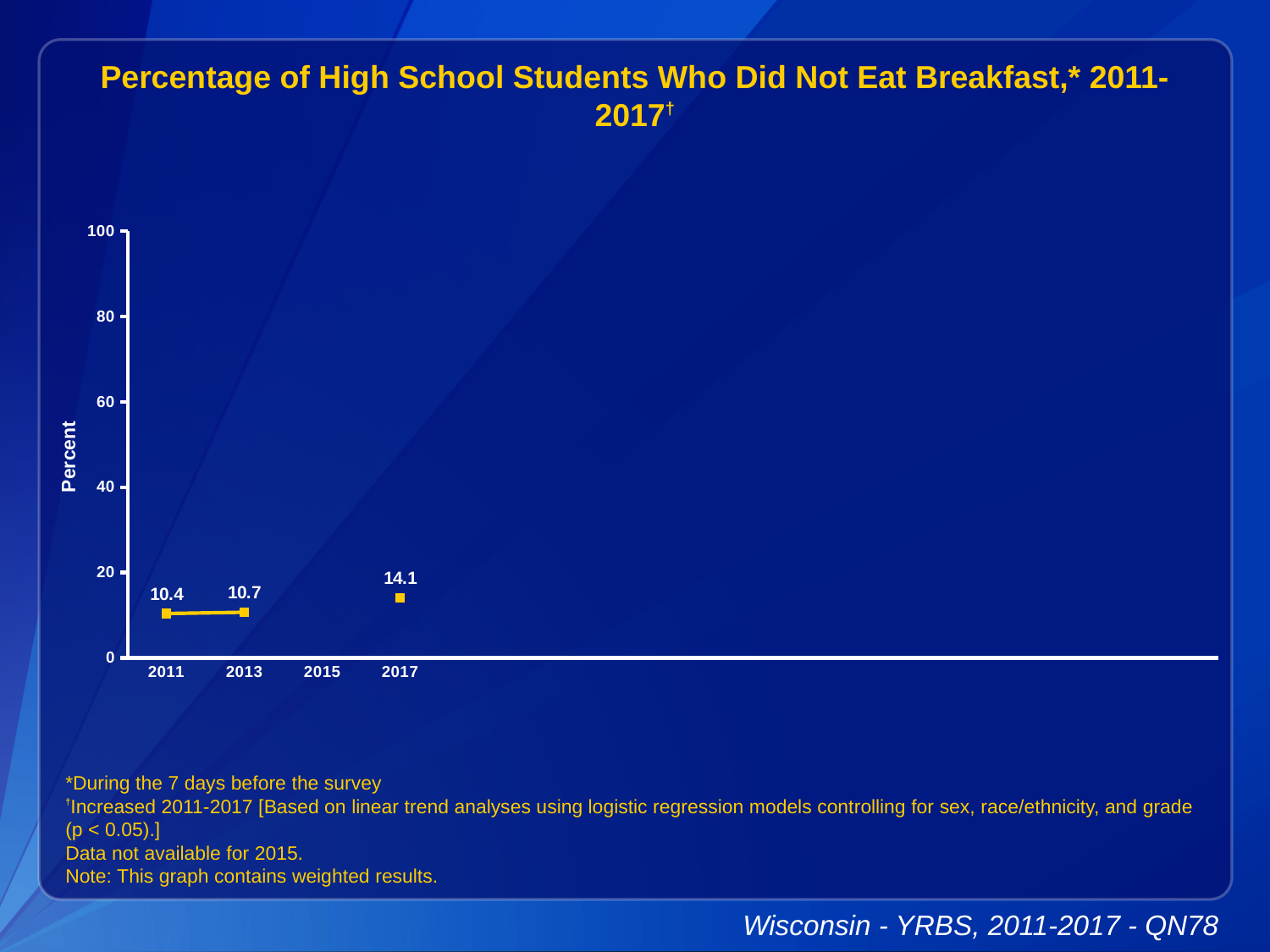
Which year has the highest value? 2017 What kind of chart is this? line chart What is the label on the y axis? Percent Which is larger, the value for 2013 or the value for 2017? 2017 What is the value for 2013? 10.7 What is the difference between the values for 2017 and 2011? 3.7 How many years have a plotted data point? 3 What is the value for 2011? 10.4 Is the value for 2017 greater or less than 20? less Do the values rise or fall from 2011 to 2017? rise Which year has the lowest value? 2011 What is the value for 2017? 14.1